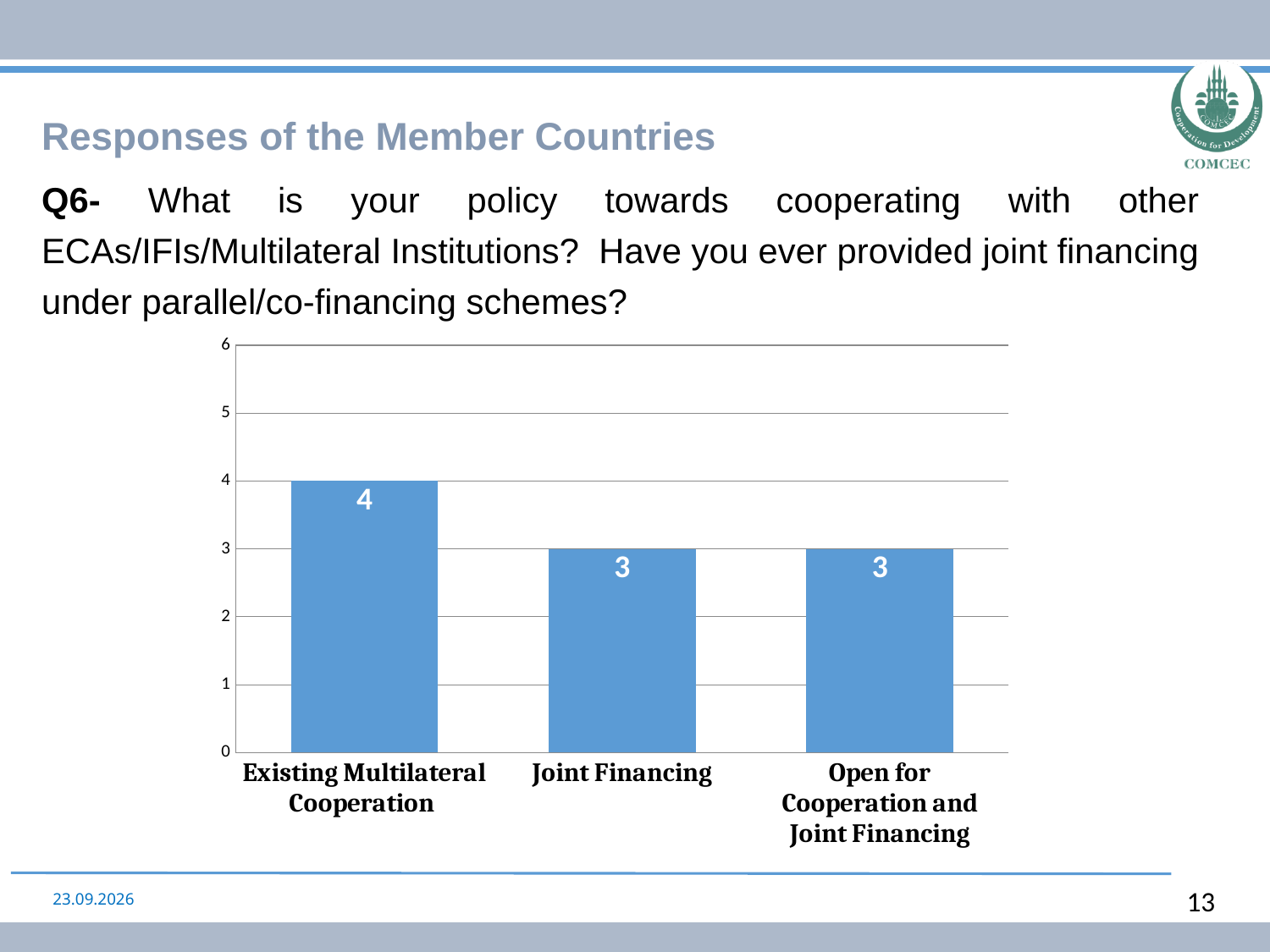
What is the value for Open for Cooperation and Joint Financing? 3 What is the value for Joint Financing? 3 What is the total of the values for all three categories? 10 What is the difference between the values for Existing Multilateral Cooperation and Joint Financing? 1 Is the value for Joint Financing greater or less than 5? less What kind of chart is shown on the slide? bar chart What is the maximum value shown on the vertical axis? 6 Which is larger, the value for Existing Multilateral Cooperation or the value for Open for Cooperation and Joint Financing? Existing Multilateral Cooperation How many categories are shown on the chart? 3 What is the value for Existing Multilateral Cooperation? 4 Which category has the highest value? Existing Multilateral Cooperation What colour are the bars in the chart? blue